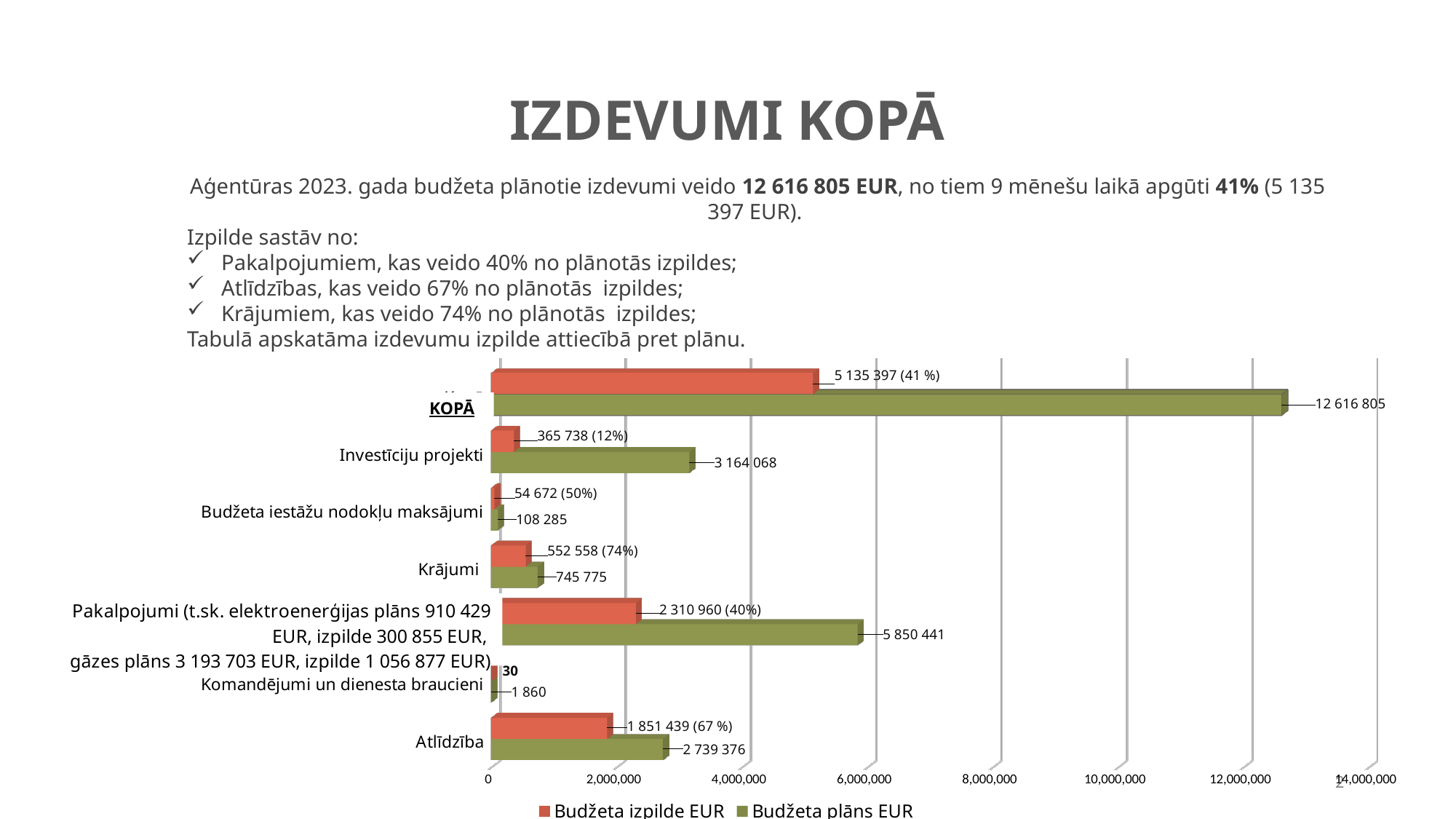
What is the Budžeta izpilde EUR value for Krājumi? 552 558 (74%) Which category has the lowest Budžeta plāns EUR value? Komandējumi un dienesta braucieni What type of chart is shown on the slide? bar chart What is the Budžeta izpilde EUR value for Atlīdzība? 1 851 439 (67 %) How many series does the chart legend list? 2 What is the Budžeta plāns EUR value for Investīciju projekti? 3 164 068 Excluding KOPĀ, which category has the highest Budžeta plāns EUR value? Pakalpojumi What is the Budžeta plāns EUR value for Komandējumi un dienesta braucieni? 1 860 Which is larger: the Budžeta plāns EUR value for Krājumi or for Budžeta iestāžu nodokļu maksājumi? Krājumi What is the Budžeta plāns EUR value for KOPĀ? 12 616 805 Is the Budžeta izpilde EUR value for Pakalpojumi greater or less than 2,000,000? greater What is the difference between the Budžeta plāns EUR and Budžeta izpilde EUR values for Atlīdzība? 887 937